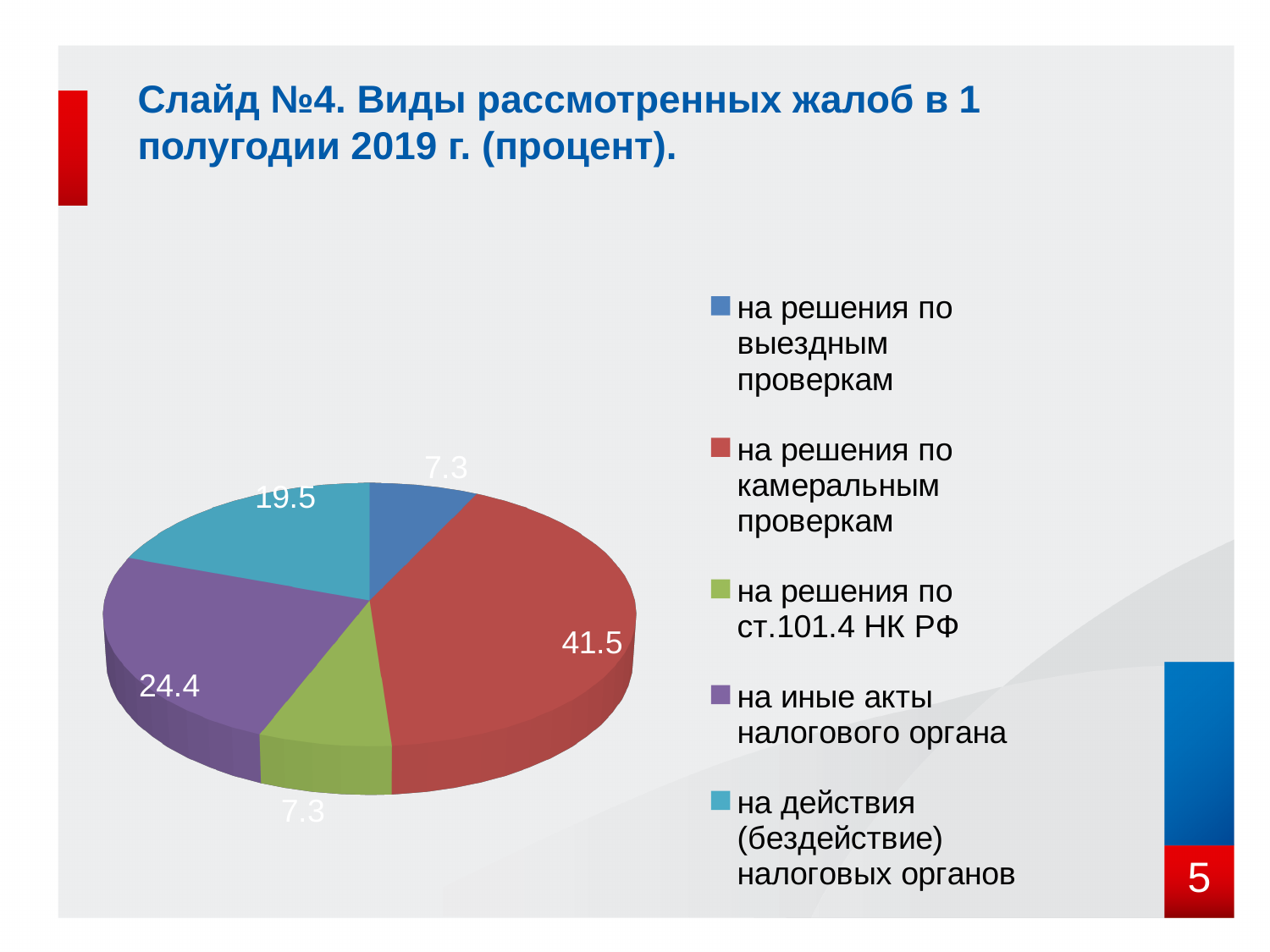
What kind of chart is shown on the slide? pie chart Which category has the largest slice of the pie? на решения по камеральным проверкам How many categories does the legend list? 5 What is the difference between the values for "на решения по камеральным проверкам" and "на иные акты налогового органа"? 17.1 What is the value for "на решения по выездным проверкам"? 7.3 What is the value for "на действия (бездействие) налоговых органов"? 19.5 Which colour represents "на решения по ст.101.4 НК РФ" in the chart? green What is the value for "на решения по камеральным проверкам"? 41.5 Which is larger: the value for "на иные акты налогового органа" or the value for "на действия (бездействие) налоговых органов"? на иные акты налогового органа What is the value for "на решения по ст.101.4 НК РФ"? 7.3 What is the value for "на иные акты налогового органа"? 24.4 What is the difference between the values for "на иные акты налогового органа" and "на действия (бездействие) налоговых органов"? 4.9